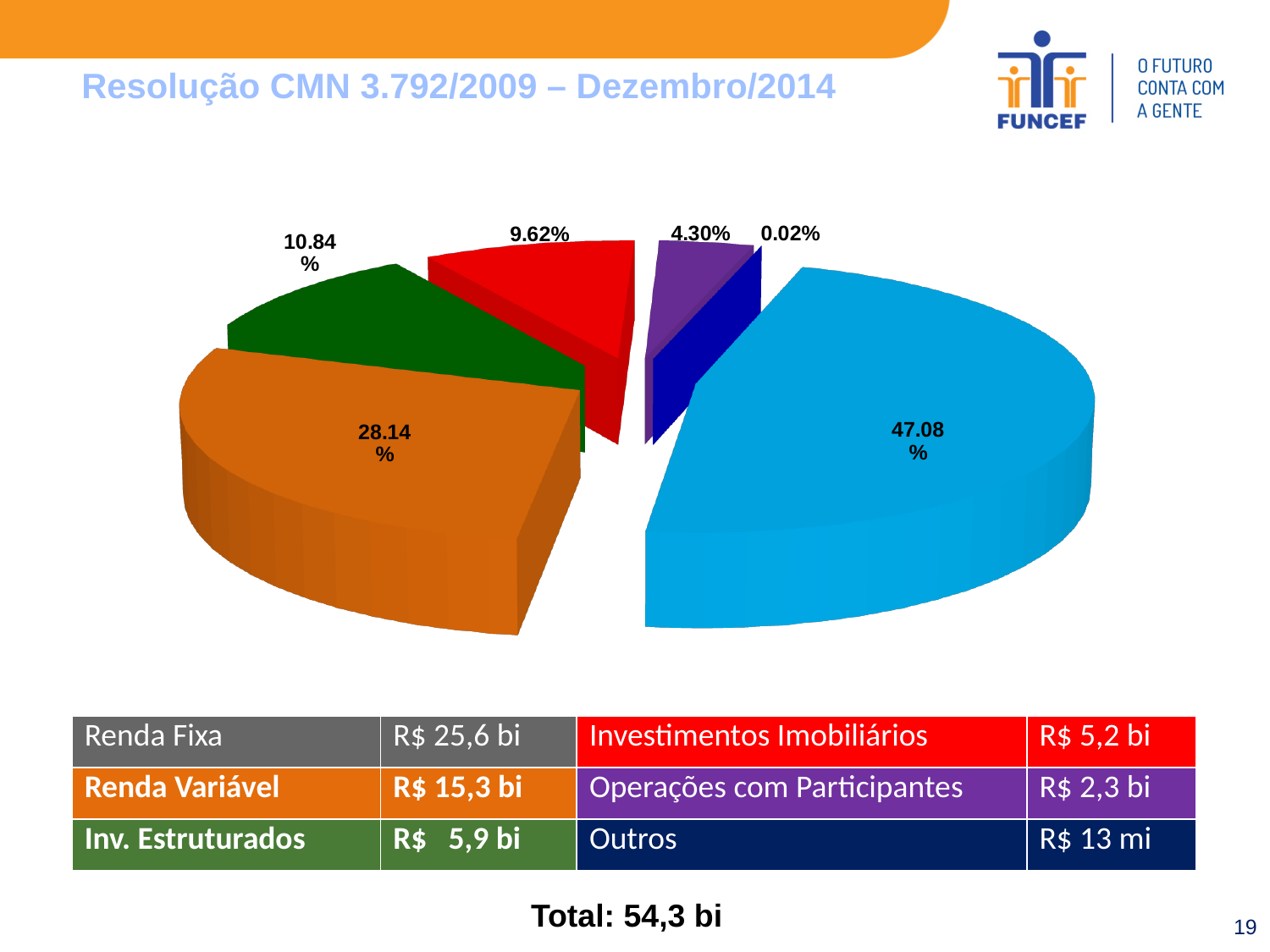
How many slices does the pie chart have? 6 What is the percentage shown on the largest slice of the pie chart? 47.08% Which slice is larger, the green slice (10.84%) or the red slice (9.62%)? the green slice According to the table below the chart, what is the value for Renda Variável? R$ 15,3 bi What total is printed below the table on the slide? 54,3 bi What kind of chart is shown on the slide? pie chart What percentage is shown on the orange slice of the pie chart? 28.14% What percentage is shown on the green slice of the pie chart? 10.84% What is the difference in percentage points between the largest slice (47.08%) and the orange slice (28.14%)? 18.94 What is the percentage shown on the smallest slice of the pie chart? 0.02% What percentage is shown on the red slice of the pie chart? 9.62% What percentage is shown on the purple slice of the pie chart? 4.30%